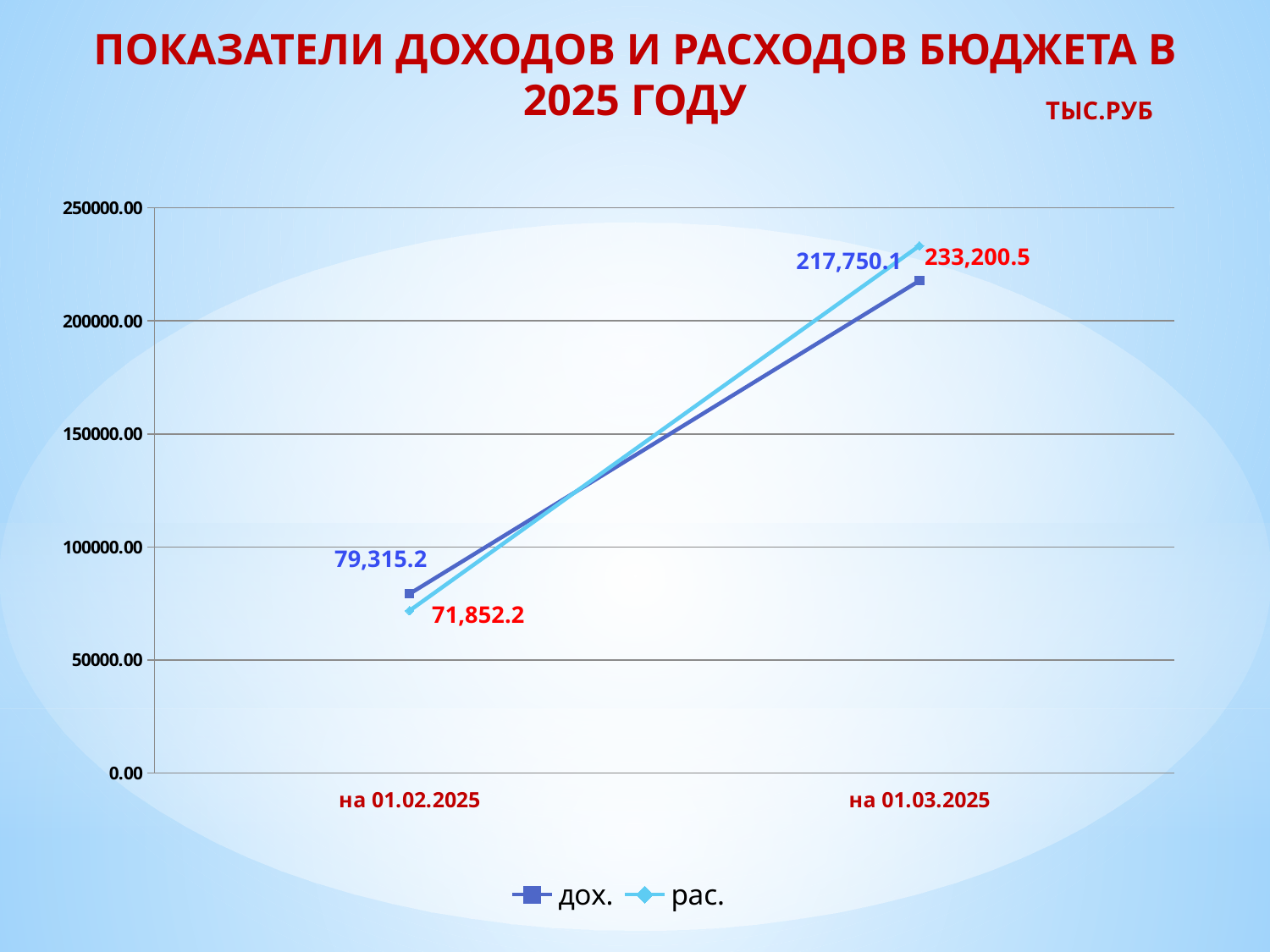
What type of chart is shown on the slide? line chart What unit is indicated in the top right of the slide? ТЫС.РУБ Which series has the higher value on 01.03.2025, дох. or рас.? рас. What is the value of рас. on 01.03.2025? 233,200.5 How many series does the legend list? 2 Does the дох. series rise or fall from 01.02.2025 to 01.03.2025? rise Which series has the higher value on 01.02.2025, дох. or рас.? дох. What is the value of дох. on 01.02.2025? 79,315.2 How many dates are shown on the x axis? 2 What is the value of дох. on 01.03.2025? 217,750.1 By how much did рас. increase from 01.02.2025 to 01.03.2025? 161,348.3 What is the value of рас. on 01.02.2025? 71,852.2